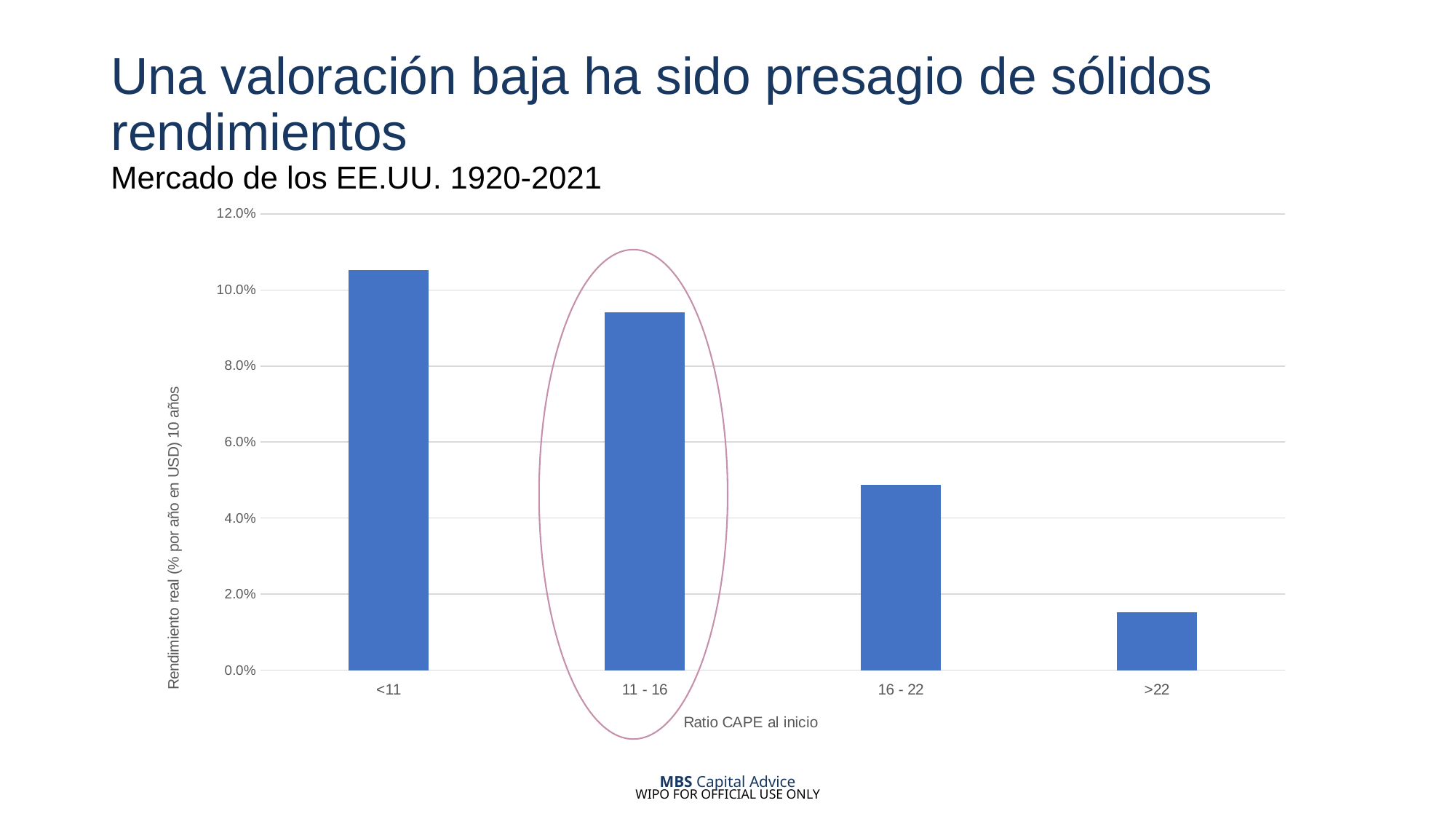
Is the value for the 11 - 16 category greater or less than 10.0%? less Is the value for the >22 category greater or less than 2.0%? less Which CAPE ratio category has the highest 10-year real return? <11 Do the values rise or fall as the CAPE ratio increases along the x axis? fall Which CAPE ratio category has the lowest 10-year real return? >22 What is the label of the x axis? Ratio CAPE al inicio Is the value for the 16 - 22 category greater or less than 6.0%? less Which bar is circled on the chart? 11 - 16 How many CAPE ratio categories are shown on the x axis? 4 Which has a higher value, the 11 - 16 category or the 16 - 22 category? 11 - 16 What kind of chart is shown on the slide? bar chart